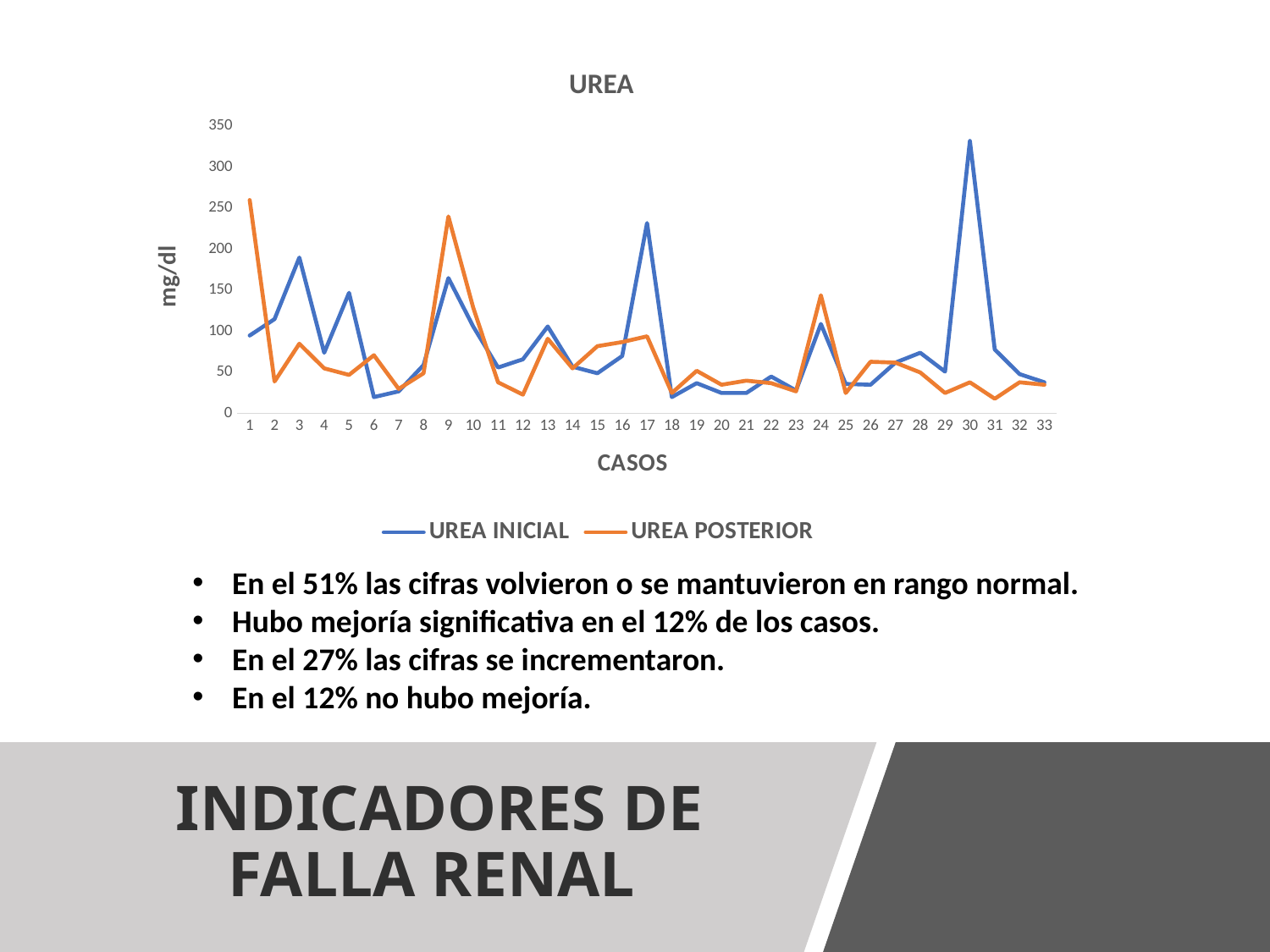
Is the UREA POSTERIOR value for case 9 greater or less than 200? greater What unit is shown on the y axis of the UREA chart? mg/dl Is the UREA INICIAL value for case 6 greater or less than 50? less At case 1, which series has the higher value, UREA INICIAL or UREA POSTERIOR? UREA POSTERIOR Is the UREA INICIAL value for case 30 greater or less than 300? greater How many series does the legend of the UREA chart list? 2 At case 17, which series has the higher value, UREA INICIAL or UREA POSTERIOR? UREA INICIAL What kind of chart is shown on the slide? line chart In the UREA chart, at which case does the UREA POSTERIOR series reach its highest value? 1 How many cases are plotted along the x axis of the UREA chart? 33 In the UREA chart, at which case does the UREA INICIAL series reach its highest value? 30